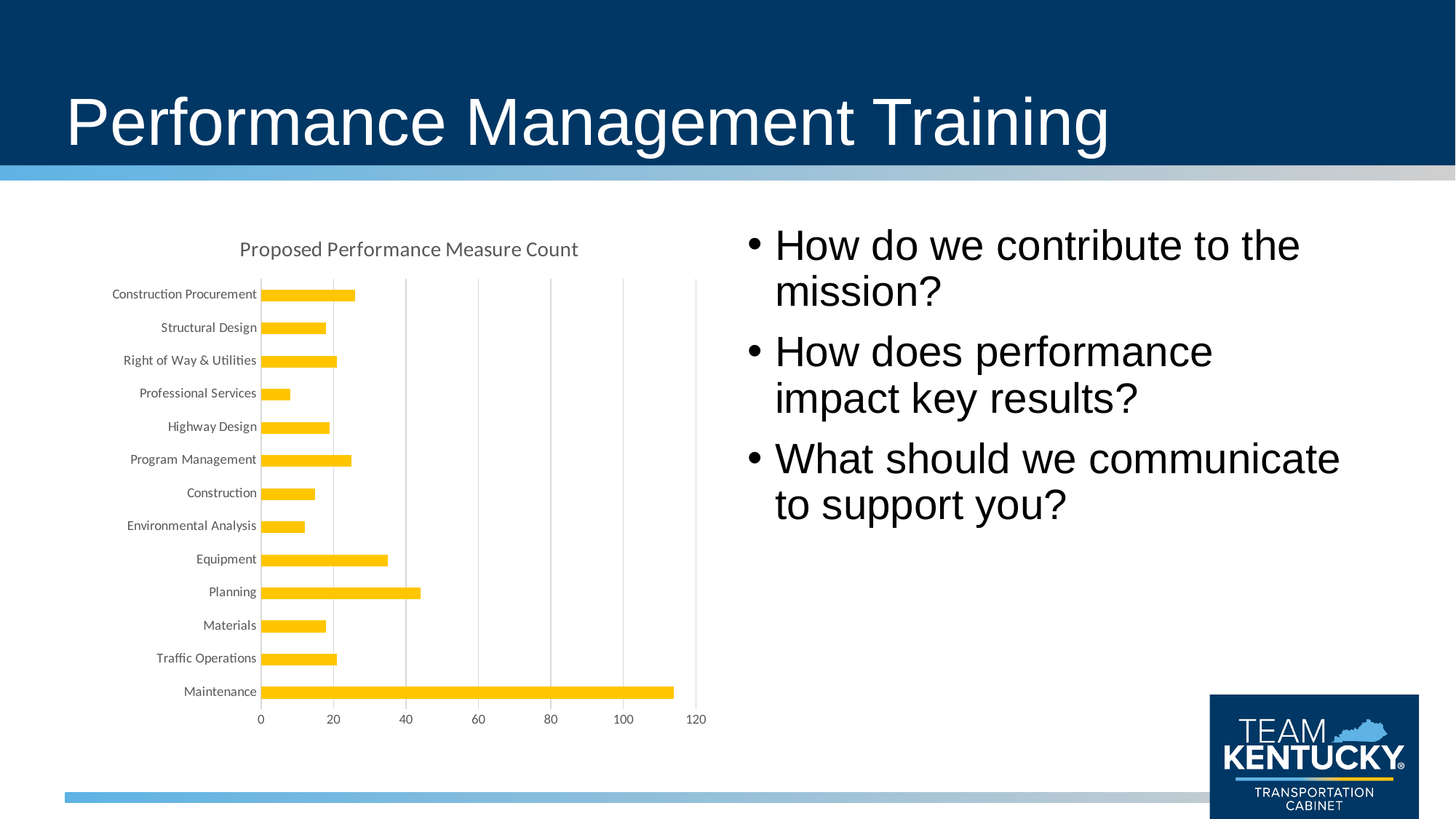
Is the value for Construction Procurement greater or less than 20? greater Is the value for Professional Services greater or less than 20? less What kind of chart is shown on the slide? Bar chart Is the value for Maintenance greater or less than 100? greater Which category has the lowest proposed performance measure count? Professional Services Which has a larger value, Construction or Environmental Analysis? Construction How many categories are plotted in the chart? 13 Which has a larger value, Planning or Equipment? Planning What is the title of the chart? Proposed Performance Measure Count Which category has the highest proposed performance measure count? Maintenance